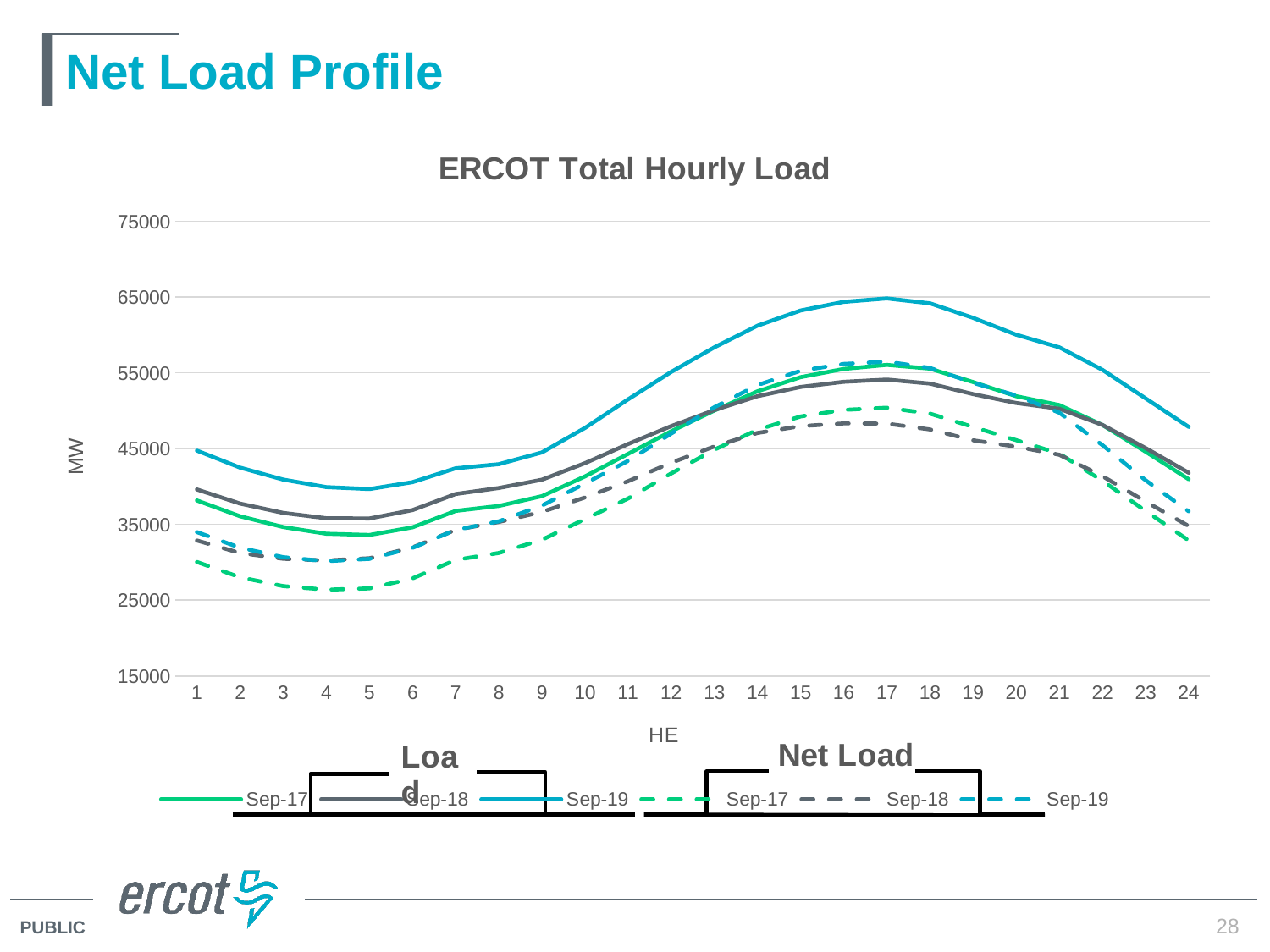
What kind of chart is shown on the slide? line chart How many series does the legend list? 6 What is the title of the chart? ERCOT Total Hourly Load At HE 17, which is higher: Load Sep-19 or Load Sep-18? Load Sep-19 How many hours (HE) are shown along the x axis? 24 Which series reaches the highest value on the chart? Load Sep-19 What is the label on the y axis? MW Is the Load Sep-19 value at HE 17 greater or less than 55000? greater From HE 17 to HE 24, does the Load Sep-19 line rise or fall? fall Which series has the lowest value at HE 4? Net Load Sep-17 Is the Load Sep-18 value at HE 1 greater or less than 45000? less Is the Net Load Sep-17 value at HE 4 greater or less than 35000? less